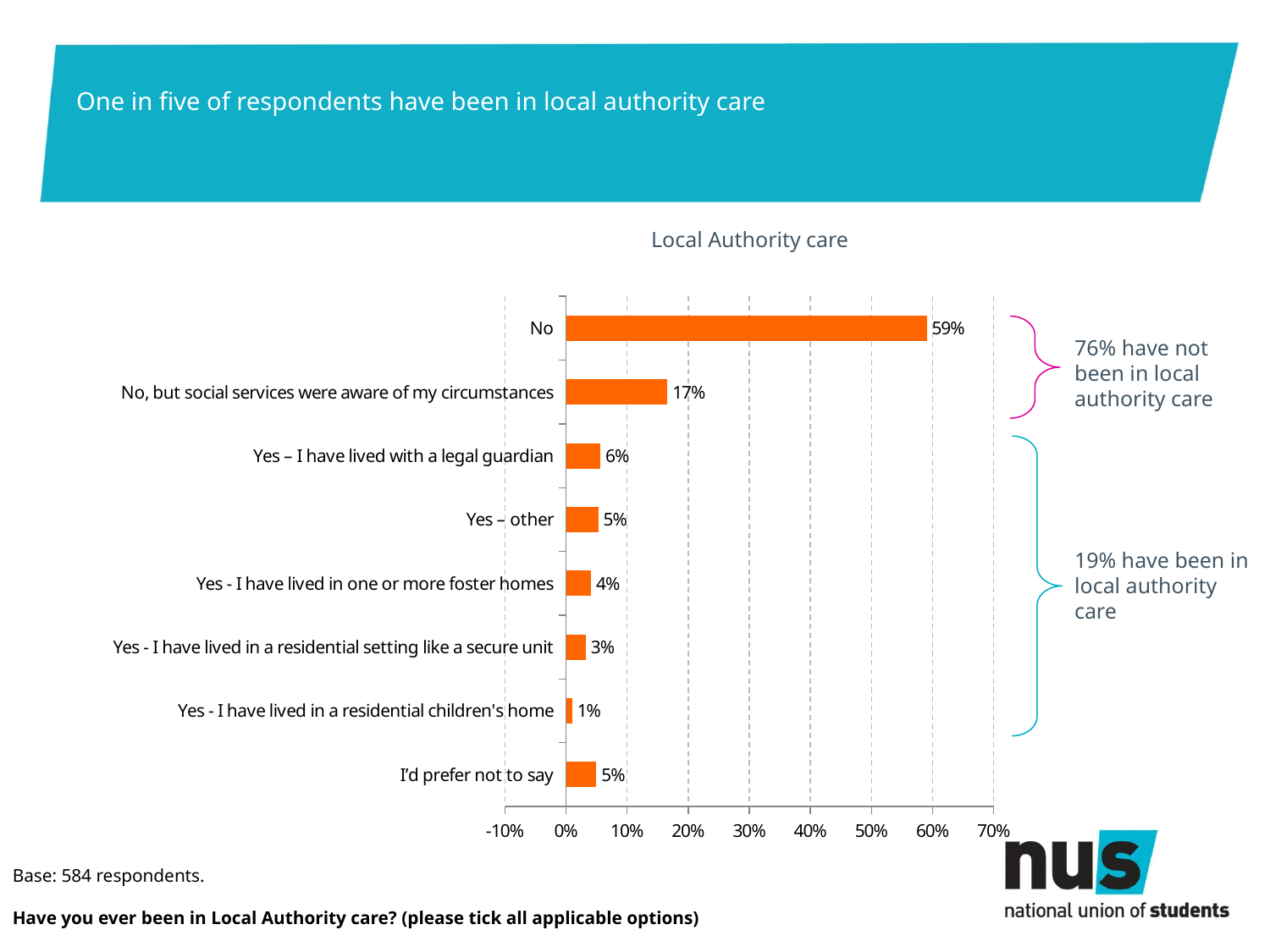
What colour are the bars in the chart? Orange What percentage of respondents said "Yes – I have lived with a legal guardian"? 6% What kind of chart is shown on the slide? Bar chart How many categories are shown in the chart? 8 Which is larger: the value for "Yes - I have lived in one or more foster homes" or the value for "Yes - I have lived in a residential setting like a secure unit"? Yes - I have lived in one or more foster homes What is the value for "No, but social services were aware of my circumstances"? 17% What is the value for "Yes - I have lived in a residential children's home"? 1% What is the title of the chart? Local Authority care Which category has the highest value? No What percentage of respondents answered "No"? 59% Which category has the lowest value? Yes - I have lived in a residential children's home What is the difference between the "No" value and the "No, but social services were aware of my circumstances" value? 42%